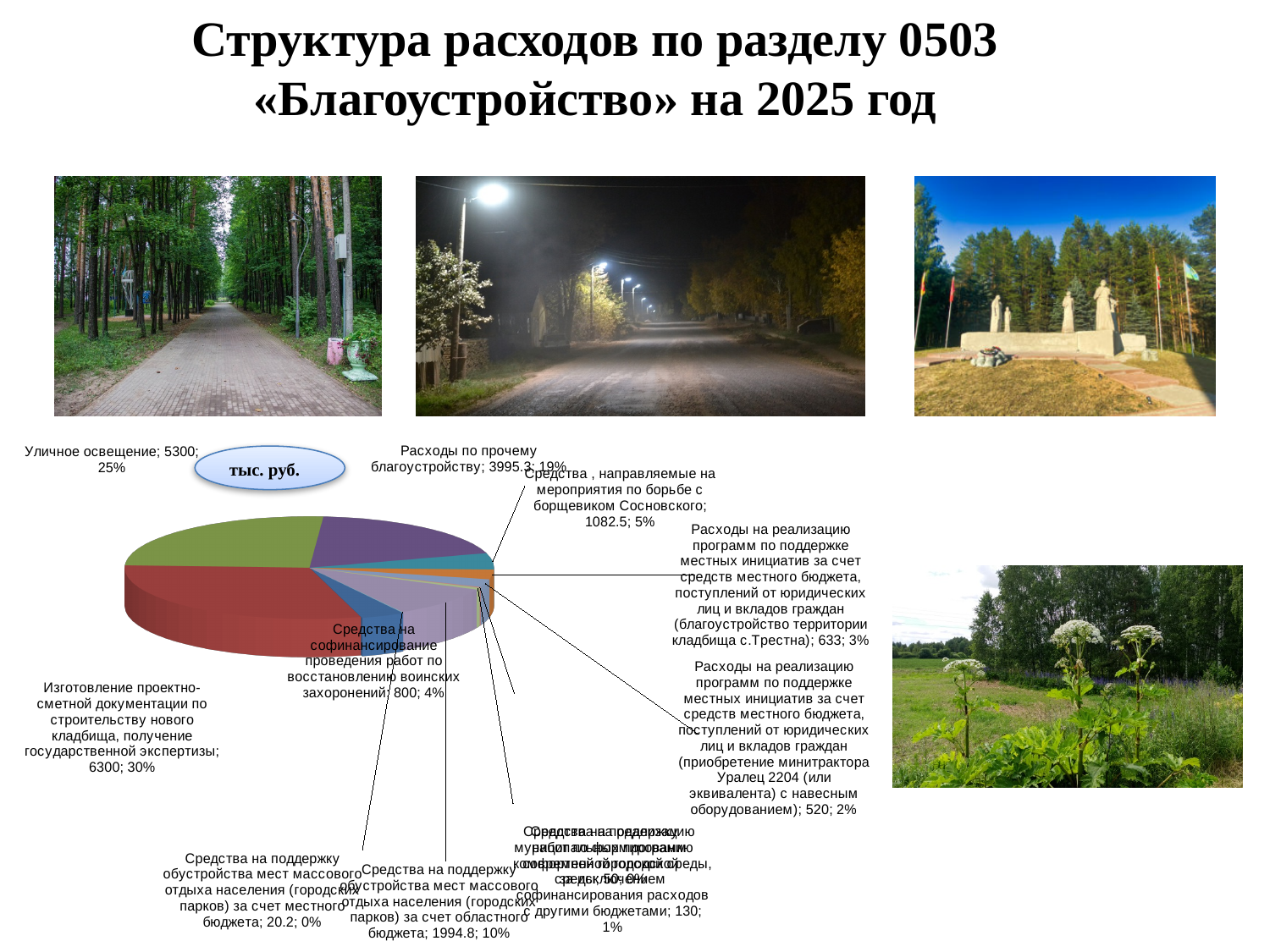
In what units are the chart values given, according to the label on the slide? тыс. руб. What value is shown for "Расходы по прочему благоустройству"? 3995.3 What value is shown for "Средства на софинансирование проведения работ по восстановлению воинских захоронений"? 800 What is the difference between the values for "Уличное освещение" and "Расходы по прочему благоустройству"? 1304.7 What share of the pie does "Изготовление проектно-сметной документации по строительству нового кладбища, получение государственной экспертизы" represent? 30% What share of the pie does "Уличное освещение" represent? 25% What value is shown for "Средства, направляемые на мероприятия по борьбе с борщевиком Сосновского"? 1082.5 What kind of chart is shown on the slide? pie chart Which category has the largest share of the pie? Изготовление проектно-сметной документации по строительству нового кладбища, получение государственной экспертизы Which is larger: the value for "Средства на поддержку обустройства мест массового отдыха населения (городских парков) за счет областного бюджета" or for "Средства на поддержку обустройства мест массового отдыха населения (городских парков) за счет местного бюджета"? за счет областного бюджета (1994.8) What value is shown for "Уличное освещение"? 5300 What share of the pie does the category for purchasing the minitractor Уралец 2204 represent? 2%